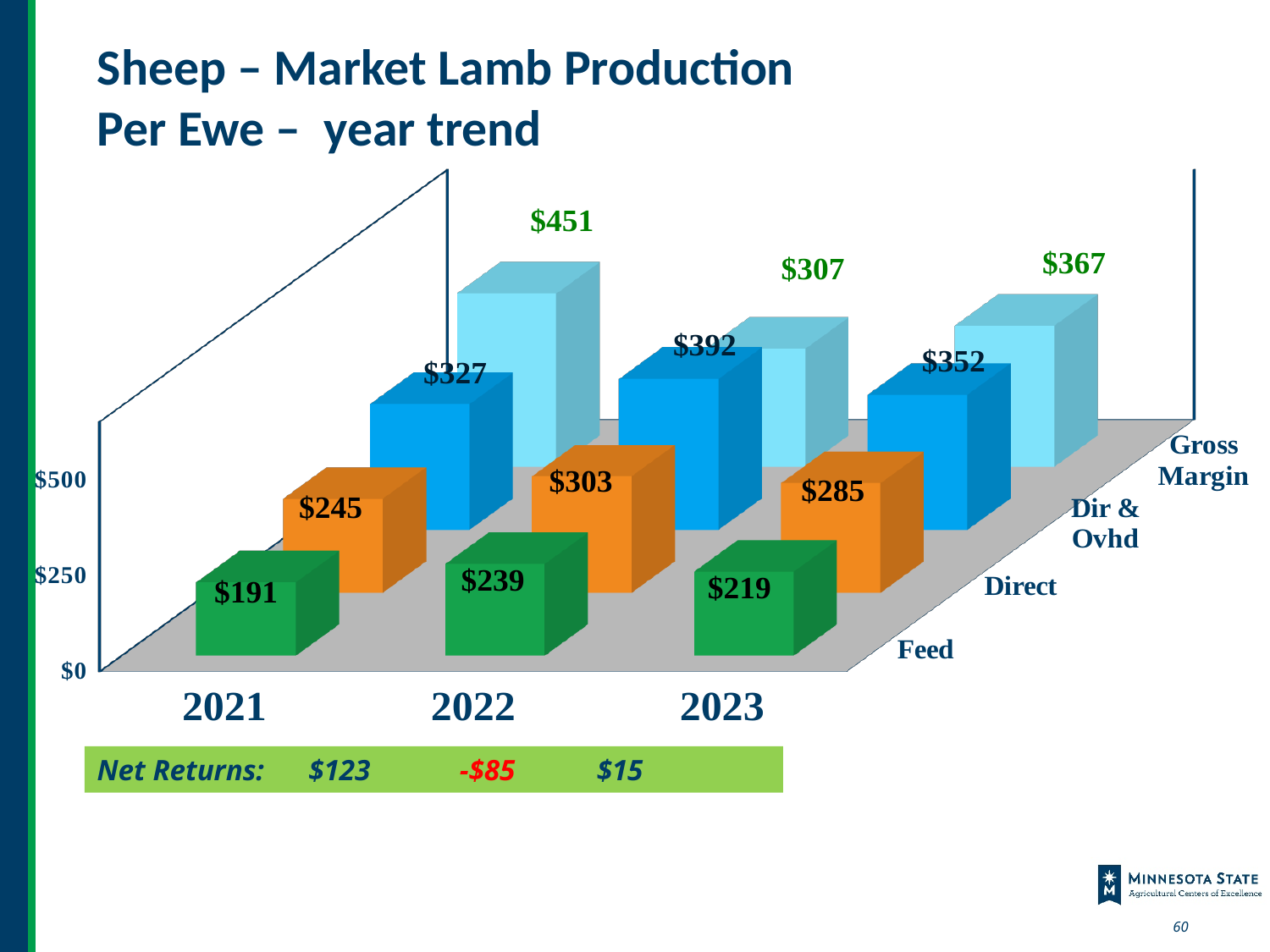
What is the Gross Margin value for 2022? $307 Which is larger, the Gross Margin for 2023 or the Gross Margin for 2022? 2023 What kind of chart is shown on the slide? Bar chart What is the Feed value for 2021? $191 How many series (rows of bars) does the chart show? 4 What is the difference between the Direct value in 2022 and in 2021? $58 What is the Dir & Ovhd value for 2023? $352 What is the Direct value for 2022? $303 How many years are shown on the x axis of the chart? 3 Which year has the highest Gross Margin? 2021 Which year has the lowest Feed value? 2021 Does the Dir & Ovhd value rise or fall from 2022 to 2023? Fall